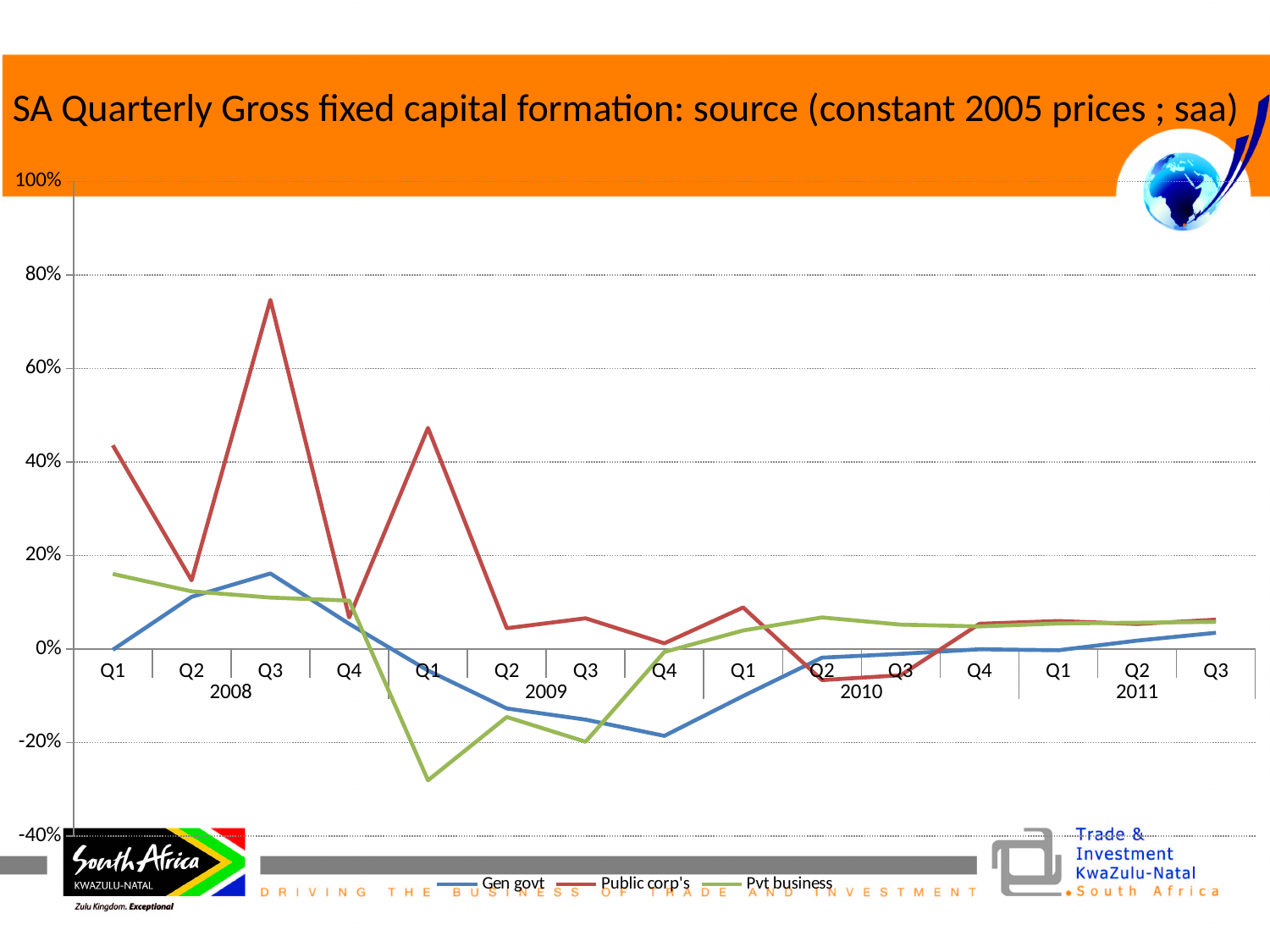
In which quarter does the Pvt business series reach its lowest value? Q1 2009 In which quarter does the Gen govt series reach its lowest value? Q4 2009 How many quarters are plotted along the x axis? 15 What kind of chart is shown on the slide? line chart In Q1 2008, which series has the higher value, Public corp's or Gen govt? Public corp's How many series does the legend list? 3 Is the value for Public corp's in Q1 2009 greater or less than 40%? greater Does the Public corp's series rise or fall from Q3 2008 to Q4 2008? fall Is the value for Public corp's in Q3 2008 greater or less than 60%? greater In which quarter does the Gen govt series reach its highest value? Q3 2008 In which quarter does the Public corp's series reach its highest value? Q3 2008 Is the value for Pvt business in Q1 2009 greater or less than -20%? less